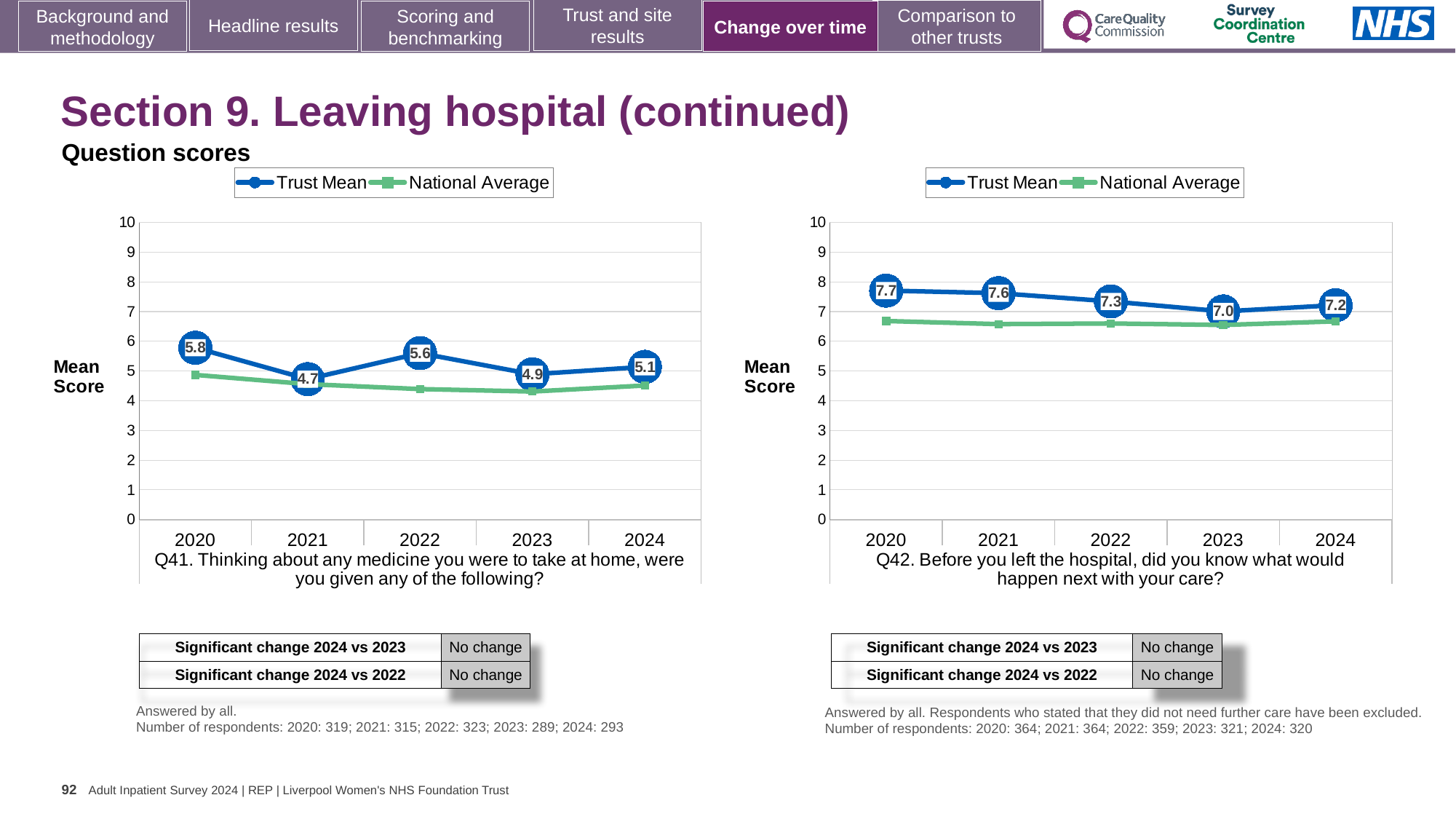
In the Q42 chart on the right, what is the Trust Mean value for 2022? 7.3 How many series does the legend of the Q41 chart on the left list? 2 In the Q41 chart on the left, which year has the lowest Trust Mean? 2021 In the Q42 chart on the right, is the National Average for 2021 greater or less than 7? less In the Q41 chart on the left, what is the difference between the Trust Mean in 2020 and in 2021? 1.1 In the Q41 chart on the left, what is the Trust Mean value for 2024? 5.1 How many years are plotted on the x axis of the Q42 chart on the right? 5 In the Q42 chart on the right, what is the difference between the Trust Mean in 2020 and in 2023? 0.7 In the Q42 chart on the right, which is larger, the Trust Mean for 2023 or for 2024? 2024 In the Q42 chart on the right, which year has the highest Trust Mean? 2020 In the Q41 chart on the left, what is the Trust Mean value for 2020? 5.8 In the Q41 chart on the left, is the National Average for 2023 greater or less than 5? less